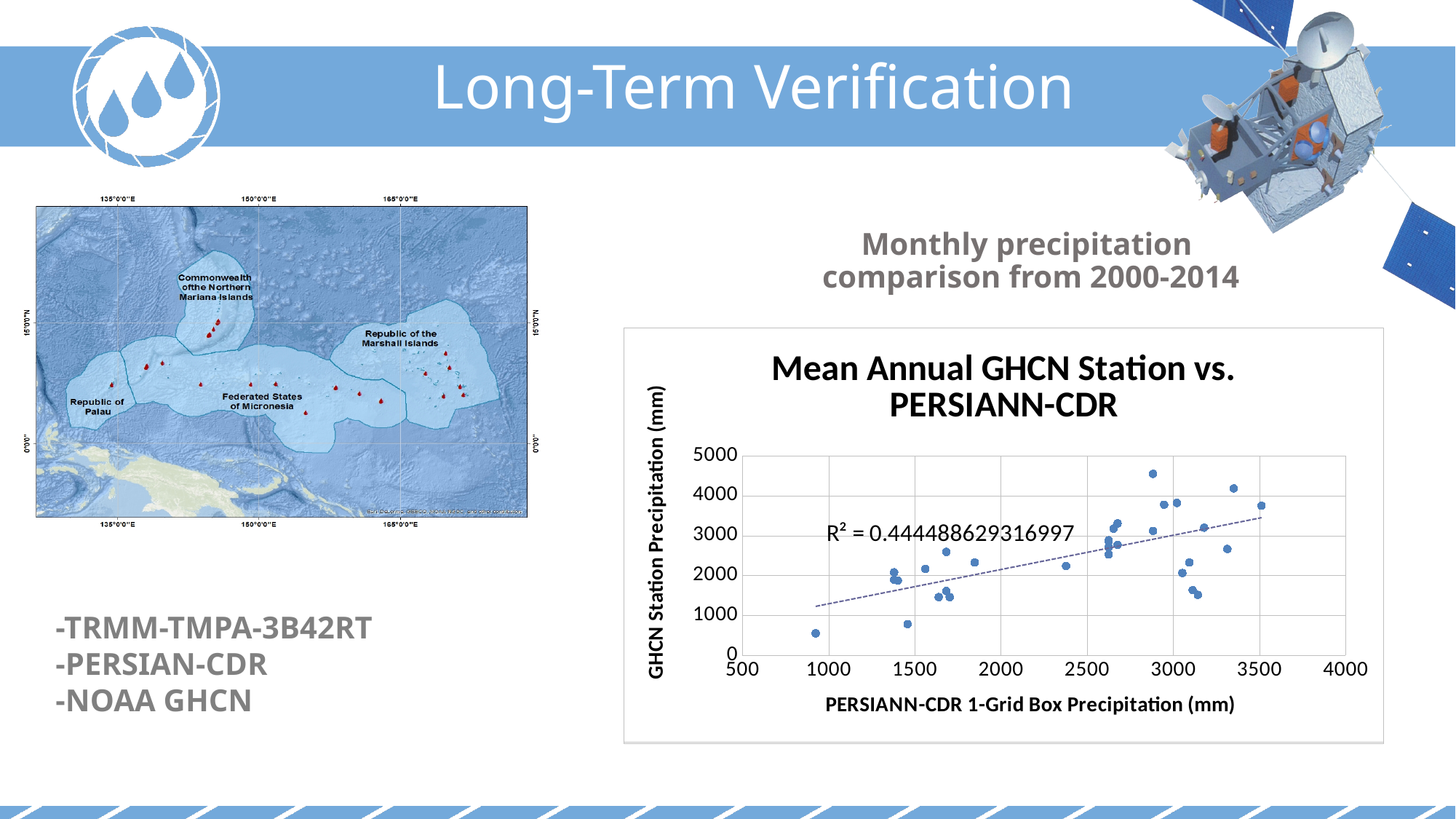
Is the GHCN Station Precipitation value of the leftmost point on the chart greater or less than 1000? less Is the GHCN Station Precipitation value of the highest point on the chart greater or less than 4000? greater What is the highest tick value shown on the x axis of the chart? 4000 Does the trend line on the chart rise or fall as PERSIANN-CDR precipitation increases? rises What is the lowest tick value shown on the x axis of the chart? 500 Is the GHCN Station Precipitation value of the rightmost point on the chart greater or less than 3000? greater What kind of chart is shown on the slide? scatter chart What is the title of the chart on the slide? Mean Annual GHCN Station vs. PERSIANN-CDR What is the label of the x axis of the chart? PERSIANN-CDR 1-Grid Box Precipitation (mm) What R² value is printed on the chart? R² = 0.444488629316997 What is the highest tick value shown on the y axis of the chart? 5000